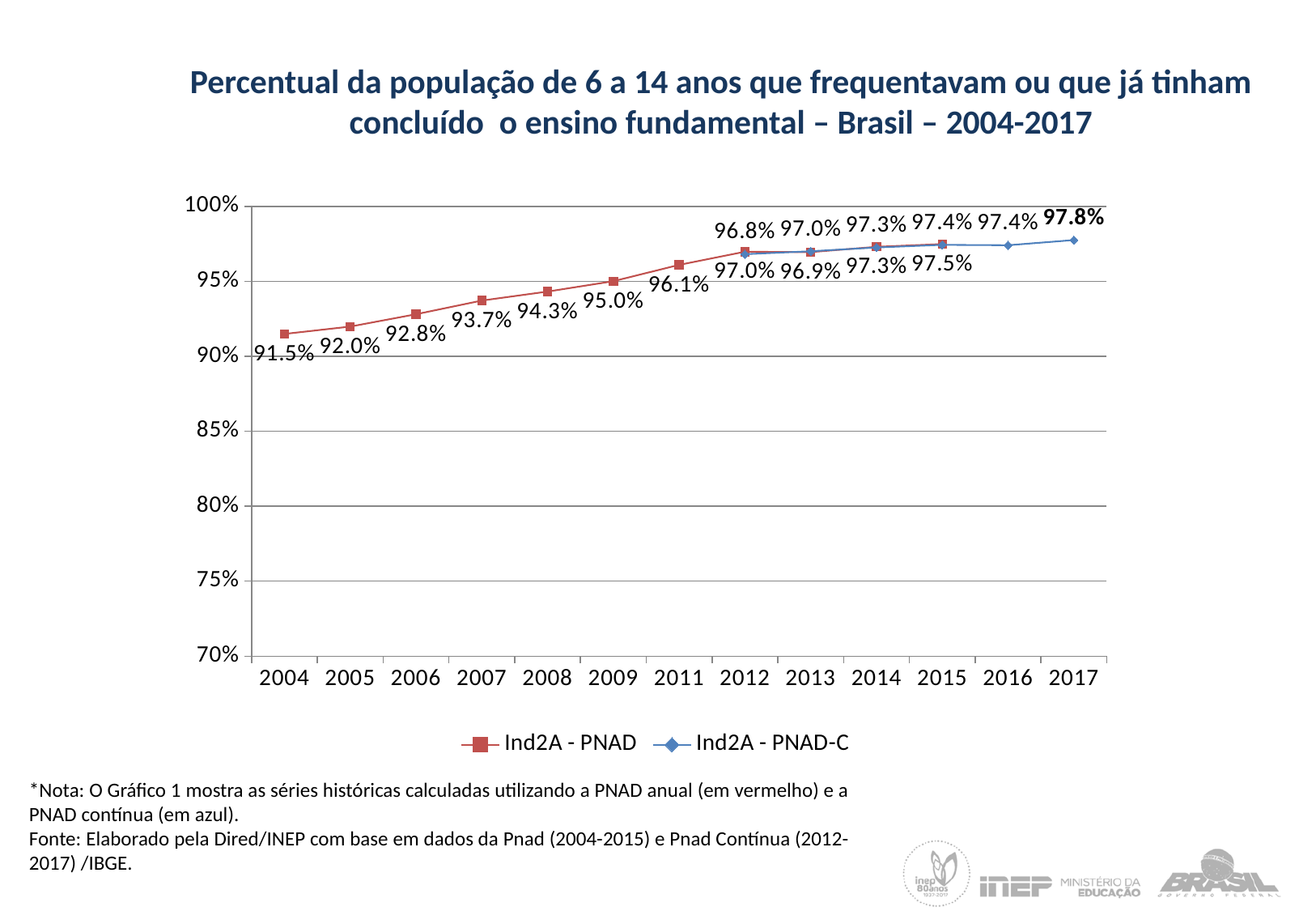
What is the value of the Ind2A - PNAD series in 2004? 91.5% What is the value of the Ind2A - PNAD series in 2009? 95.0% What is the value of the Ind2A - PNAD-C series in 2017? 97.8% In which year is the Ind2A - PNAD series at its lowest? 2004 What kind of chart is shown on the slide? Line chart What is the value of the Ind2A - PNAD-C series in 2016? 97.4% How many years are shown on the x axis? 13 Which is larger for the Ind2A - PNAD series, the value in 2006 or the value in 2008? 2008 By how many percentage points did the Ind2A - PNAD series increase from 2004 to 2011? 4.6 percentage points What colour is the Ind2A - PNAD-C line? Blue Do the values generally rise or fall from 2004 to 2017? Rise How many series does the legend list? 2